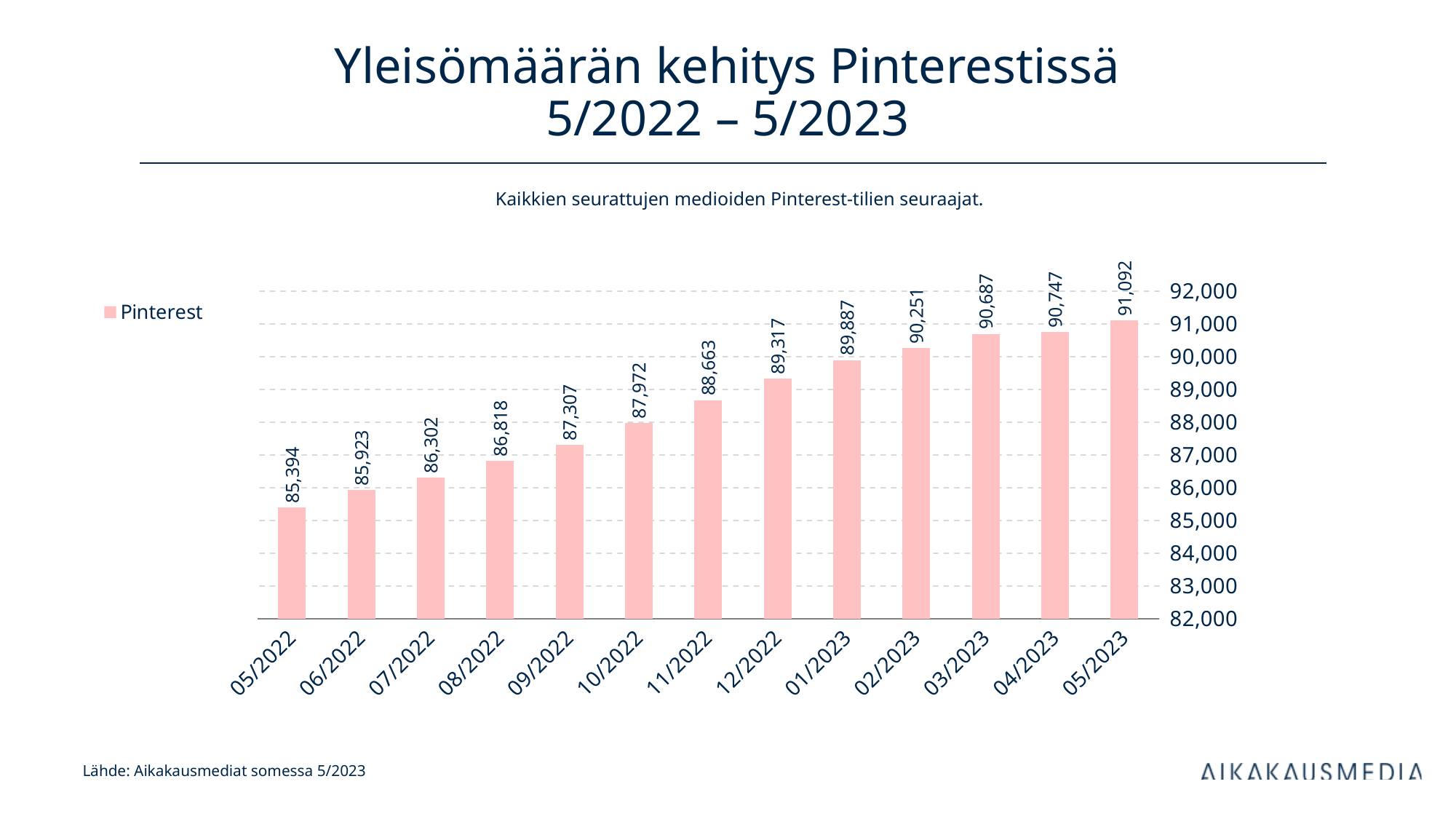
Do the values rise or fall from 05/2022 to 05/2023? rise What is the value for 05/2022? 85,394 Is the value for 08/2022 greater or less than 87,000? less What is the difference between the values for 01/2023 and 12/2022? 570 What is the value for 03/2023? 90,687 Which month has the lowest value? 05/2022 What is the value for 11/2022? 88,663 Which is larger, the value for 09/2022 or the value for 10/2022? 10/2022 Which month has the highest value? 05/2023 What kind of chart is shown? bar chart How many months are shown on the x axis? 13 What is the difference between the values for 05/2023 and 05/2022? 5,698